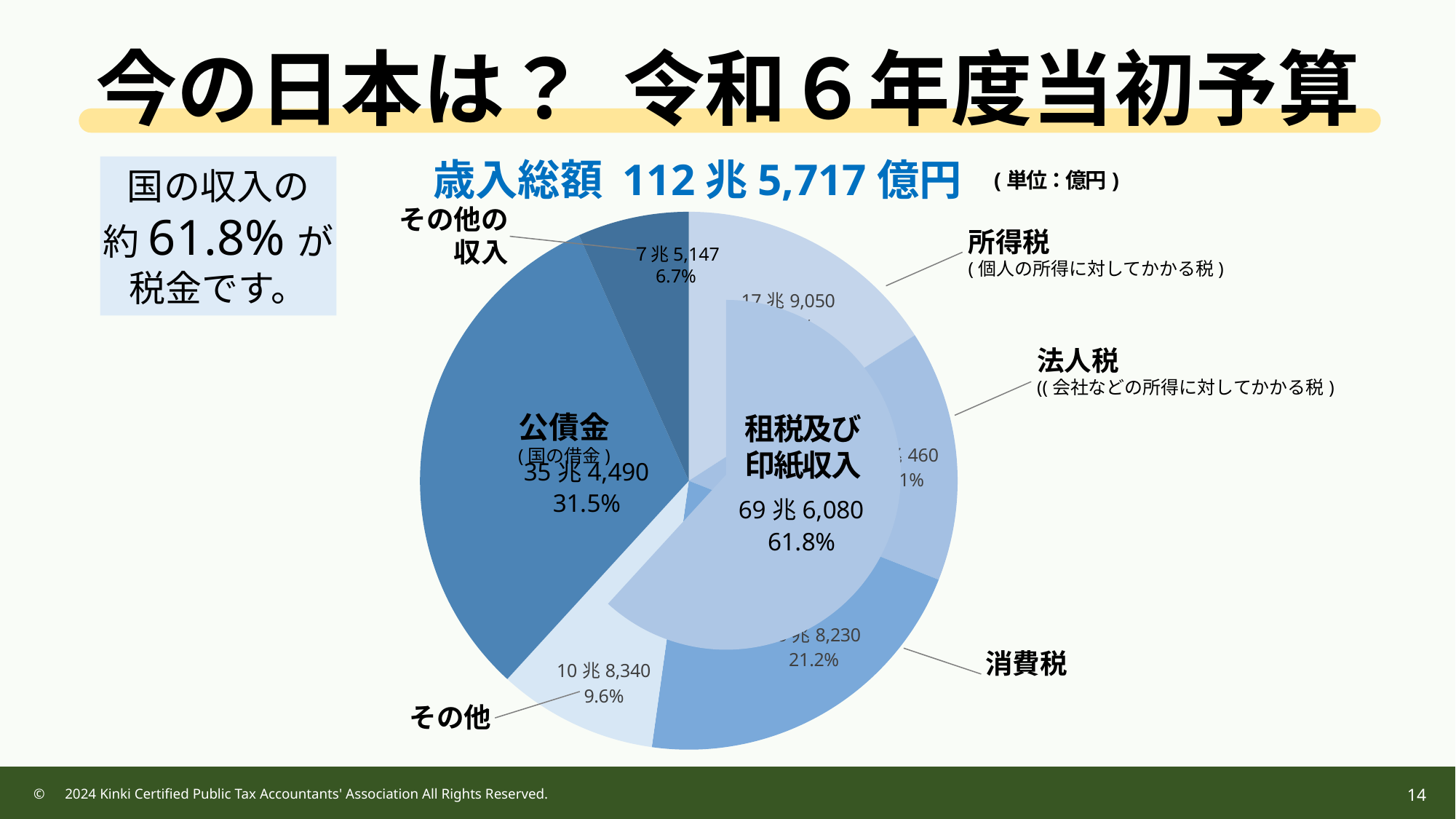
What percentage share does 消費税 have in the pie chart? 21.2% What is the value shown for 租税及び印紙収入 in the pie chart? 69 兆 6,080 What kind of chart is shown on the slide? pie chart What percentage share does 公債金 have in the pie chart? 31.5% Which slice is larger, 公債金 or その他? 公債金 What is the value shown for 公債金 in the pie chart? 35 兆 4,490 What is the value shown for 所得税 in the pie chart? 17 兆 9,050 What percentage share does その他の収入 have in the pie chart? 6.7% How many labelled slices are in the outer ring of the pie chart? 6 What total revenue (歳入総額) is stated above the pie chart? 112 兆 5,717 億円 What is the value shown for その他 in the pie chart? 10 兆 8,340 What is the difference in percentage points between the shares of 公債金 and その他? 21.9